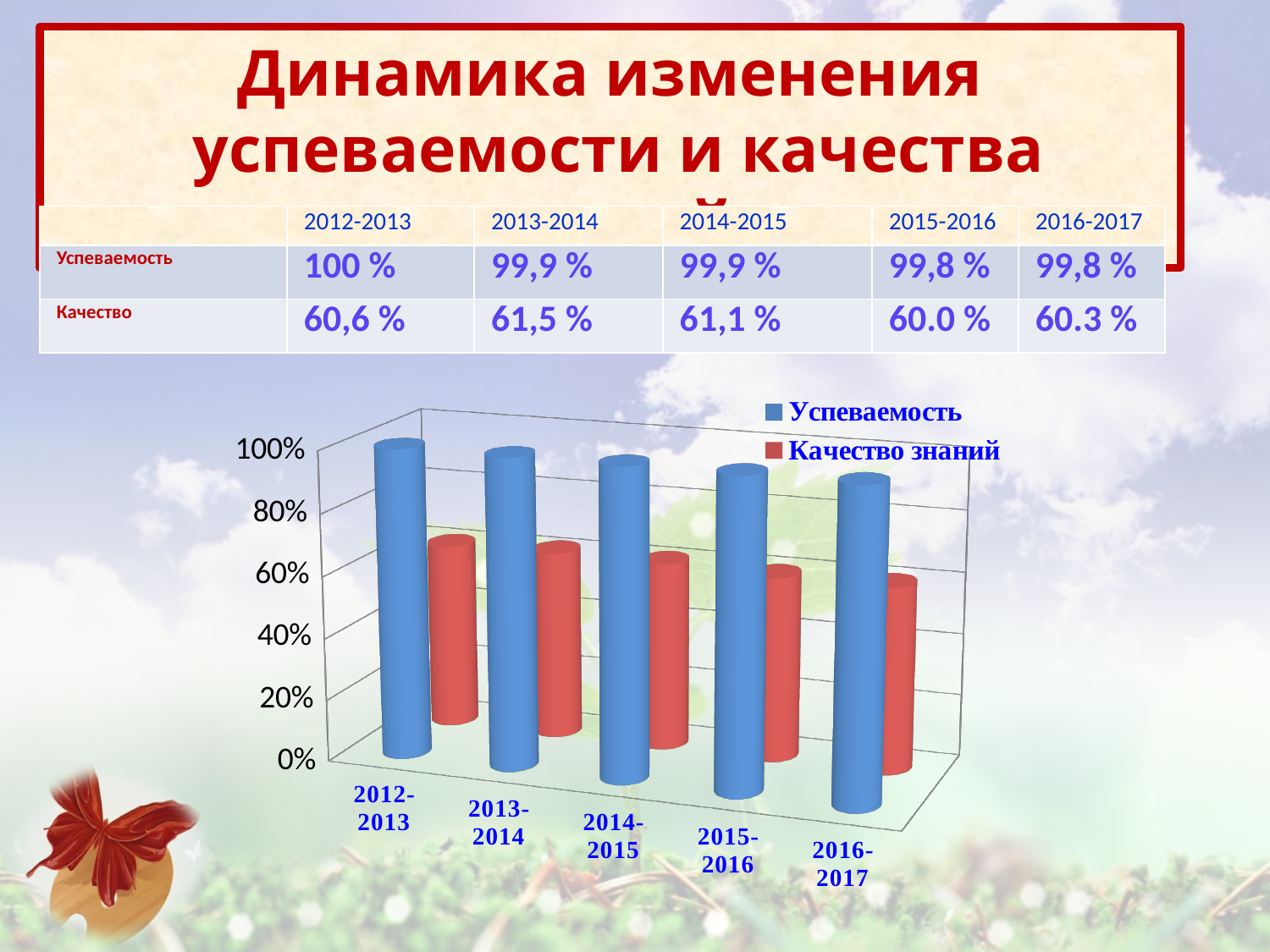
What are the two entries in the chart legend? Успеваемость, Качество знаний According to the table on the slide, what is the value of Успеваемость for 2012-2013? 100 % According to the table on the slide, in which school year is Качество lowest? 2015-2016 How many school-year categories are plotted along the x axis of the chart? 5 According to the table on the slide, in which school year is Качество highest? 2013-2014 In the chart, which series has the larger value for 2014-2015, Успеваемость or Качество знаний? Успеваемость What kind of chart is shown on the slide? bar chart Does the value of Успеваемость rise or fall from 2012-2013 to 2016-2017? fall How many series does the chart legend list? 2 In the chart, is the value of Успеваемость for 2016-2017 greater or less than 80%? greater In the chart, is the value of Качество знаний for 2012-2013 greater or less than 40%? greater According to the table on the slide, what is the value of Качество for 2013-2014? 61,5 %